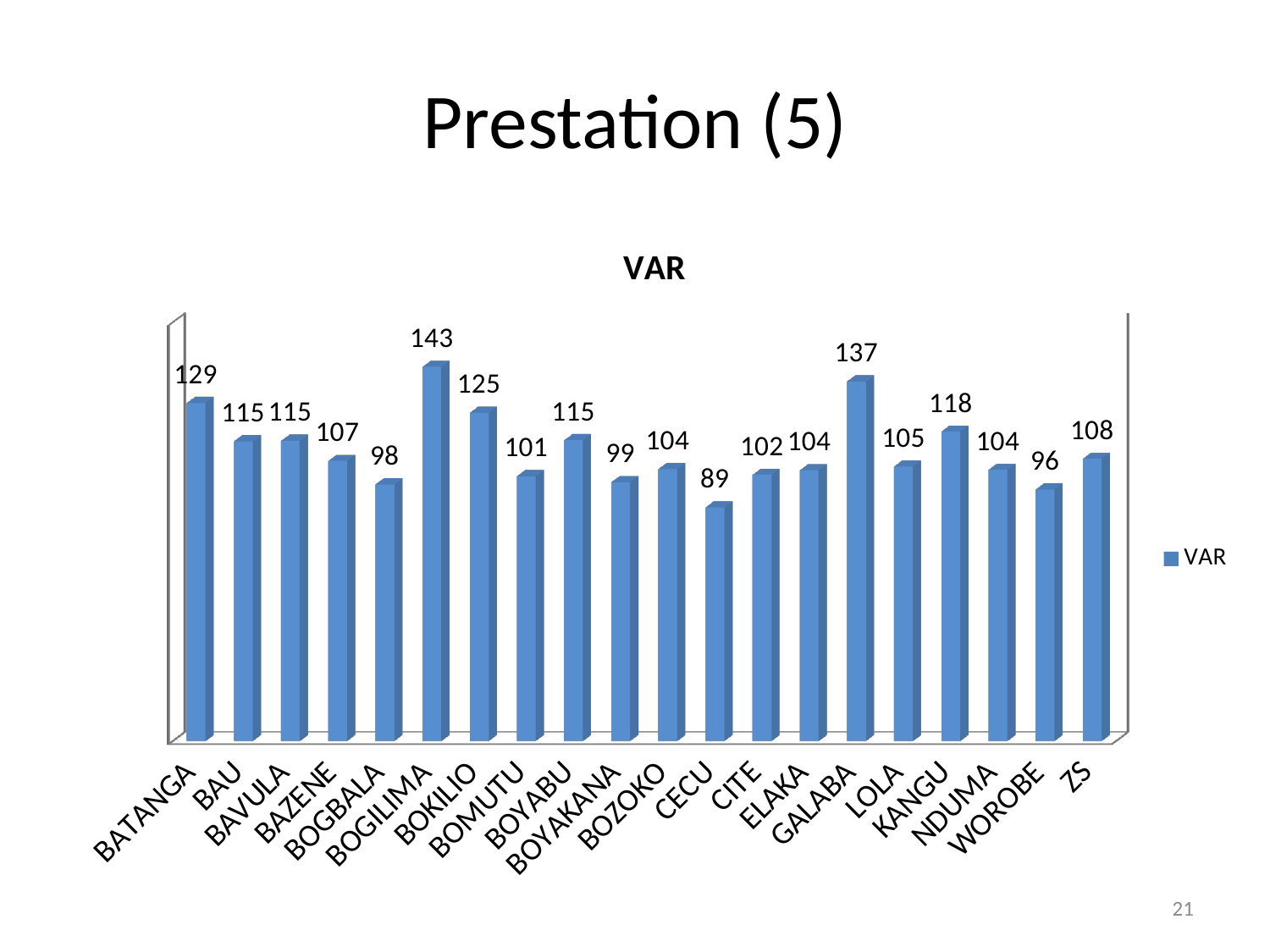
How many series does the legend list? 1 Which category has the lowest value? CECU What is the difference between the values for BATANGA and WOROBE? 33 What kind of chart is shown? bar chart What is the value for BOGILIMA? 143 What is the difference between the values for BOGILIMA and GALABA? 6 What is the value for KANGU? 118 What is the title of the chart? VAR What is the value for CECU? 89 Which is larger, the value for BOKILIO or the value for LOLA? BOKILIO How many categories are shown on the x axis? 20 Which category has the highest value? BOGILIMA